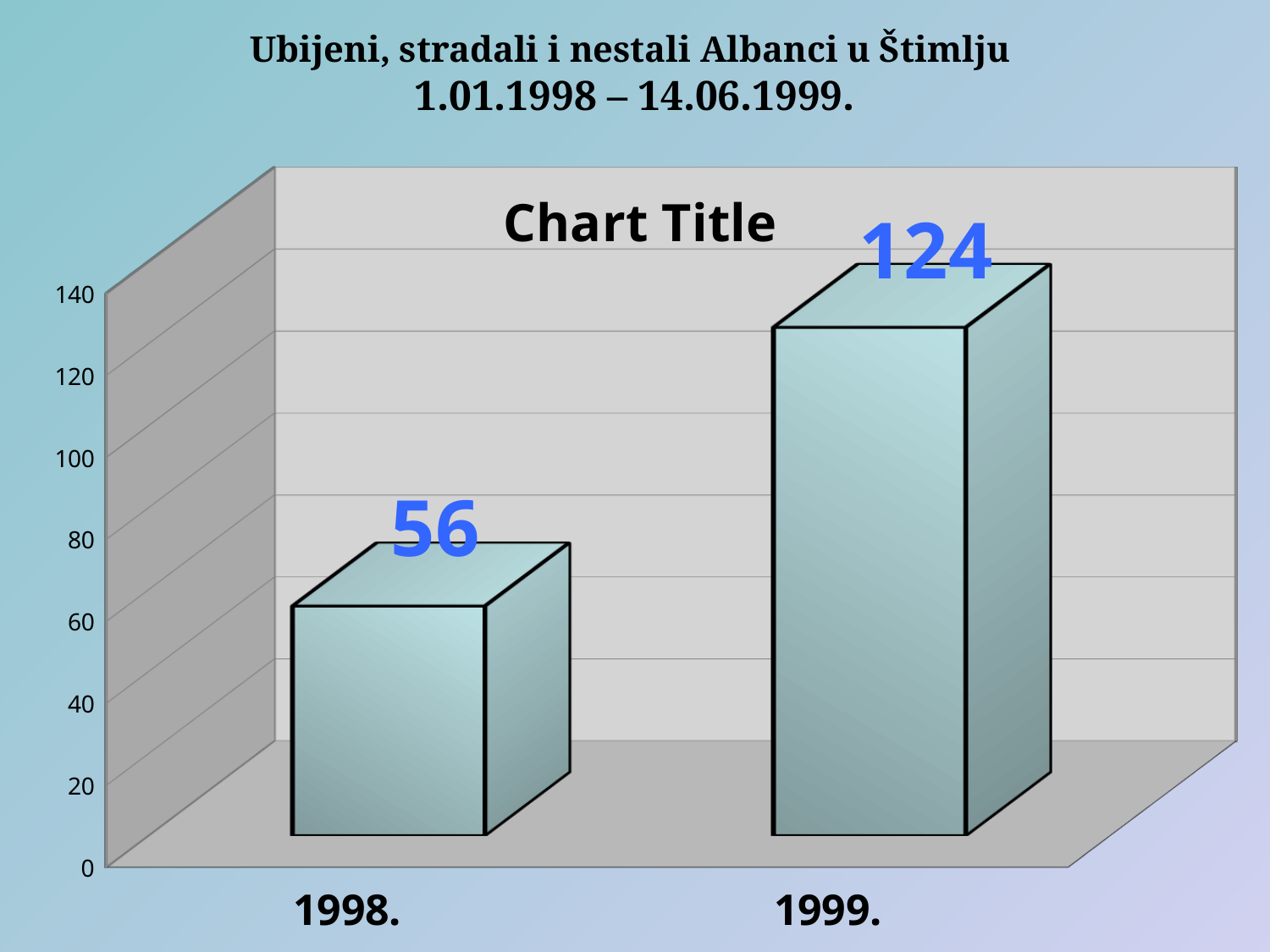
How many categories are shown on the x axis? 2 Which category has the lowest value? 1998. Is the value for 1999. greater or less than 100? greater What is the title printed inside the chart area? Chart Title Is the value for 1998. greater or less than 60? less What is the difference between the values for 1999. and 1998.? 68 Which is larger, the value for 1998. or the value for 1999.? 1999. Which category has the highest value? 1999. What is the value for 1998.? 56 What kind of chart is shown on the slide? bar chart Do the values rise or fall from 1998. to 1999.? rise What is the value for 1999.? 124